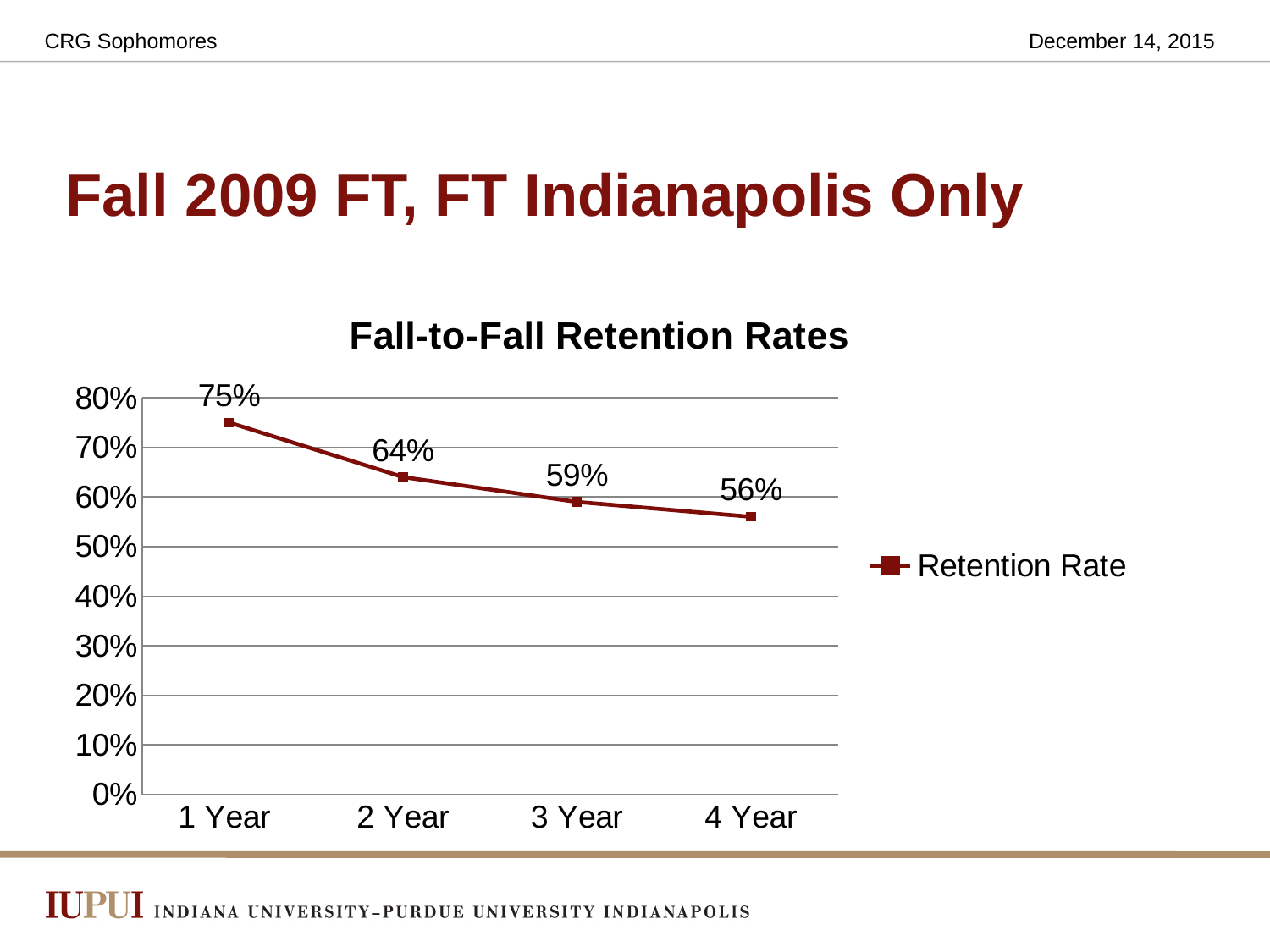
Do the retention rates rise or fall from 1 Year to 4 Year? Fall Which is larger, the retention rate at 2 Year or at 3 Year? 2 Year What is the retention rate at 2 Year? 64% How many series does the legend list? 1 Which year has the highest retention rate? 1 Year What is the retention rate at 1 Year? 75% What is the retention rate at 3 Year? 59% What is the retention rate at 4 Year? 56% Which year has the lowest retention rate? 4 Year How many data points are plotted on the chart? 4 What is the difference between the retention rate at 1 Year and at 4 Year? 19% What kind of chart is shown? Line chart